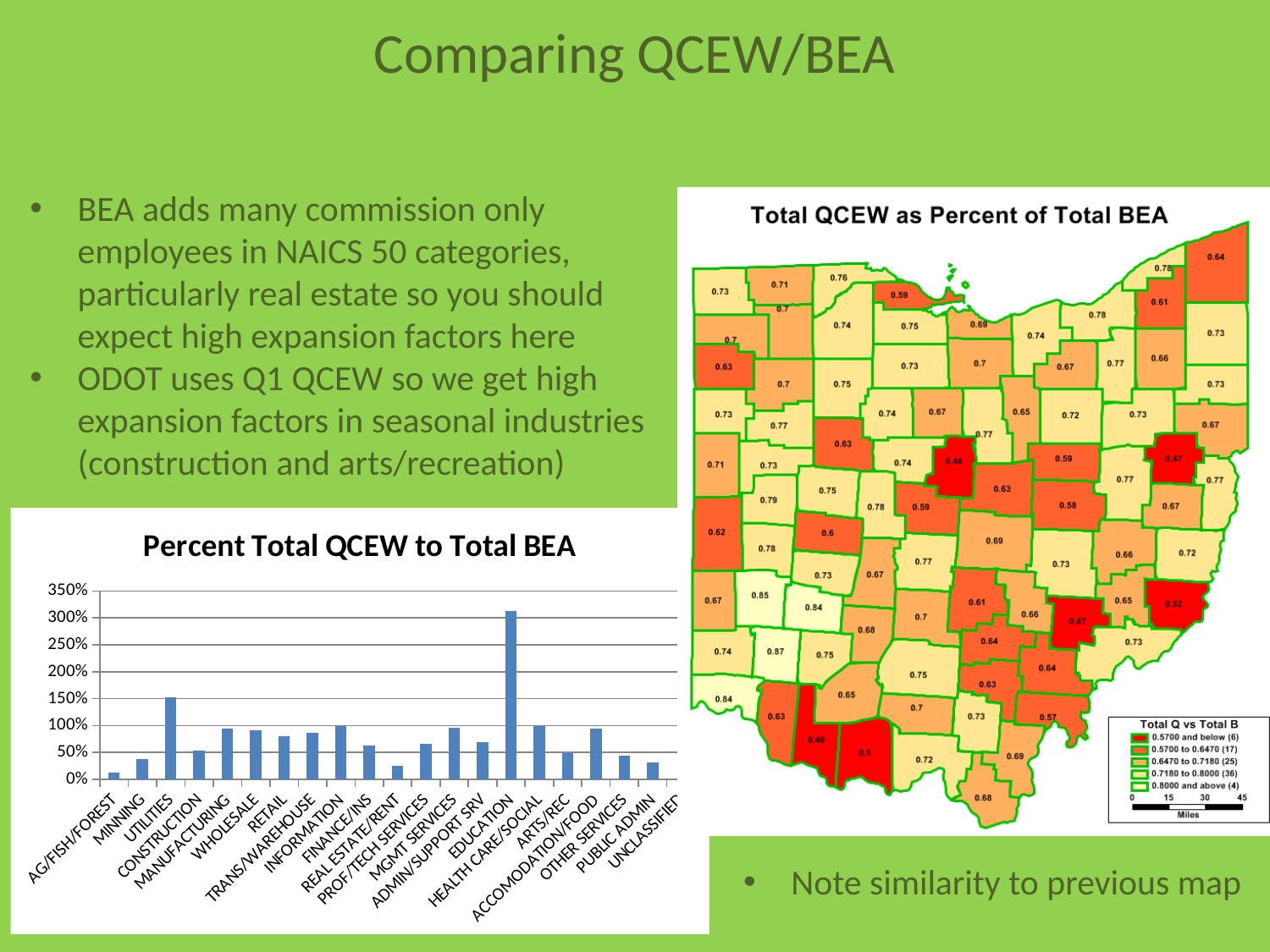
In the 'Percent Total QCEW to Total BEA' chart, is the value for EDUCATION greater or less than 250%? greater What is the highest tick value shown on the y axis of the 'Percent Total QCEW to Total BEA' chart? 350% In the 'Percent Total QCEW to Total BEA' chart, is the value for UTILITIES greater or less than 100%? greater In the 'Percent Total QCEW to Total BEA' chart, which is larger, EDUCATION or UTILITIES? EDUCATION How many categories are shown on the x axis of the 'Percent Total QCEW to Total BEA' chart? 21 In the 'Percent Total QCEW to Total BEA' chart, which category has the lowest value? AG/FISH/FOREST What type of chart is 'Percent Total QCEW to Total BEA'? bar chart In the 'Percent Total QCEW to Total BEA' chart, which category has the highest value? EDUCATION In the 'Percent Total QCEW to Total BEA' chart, is the value for CONSTRUCTION greater or less than 100%? less In the 'Percent Total QCEW to Total BEA' chart, which is larger, MINNING or AG/FISH/FOREST? MINNING